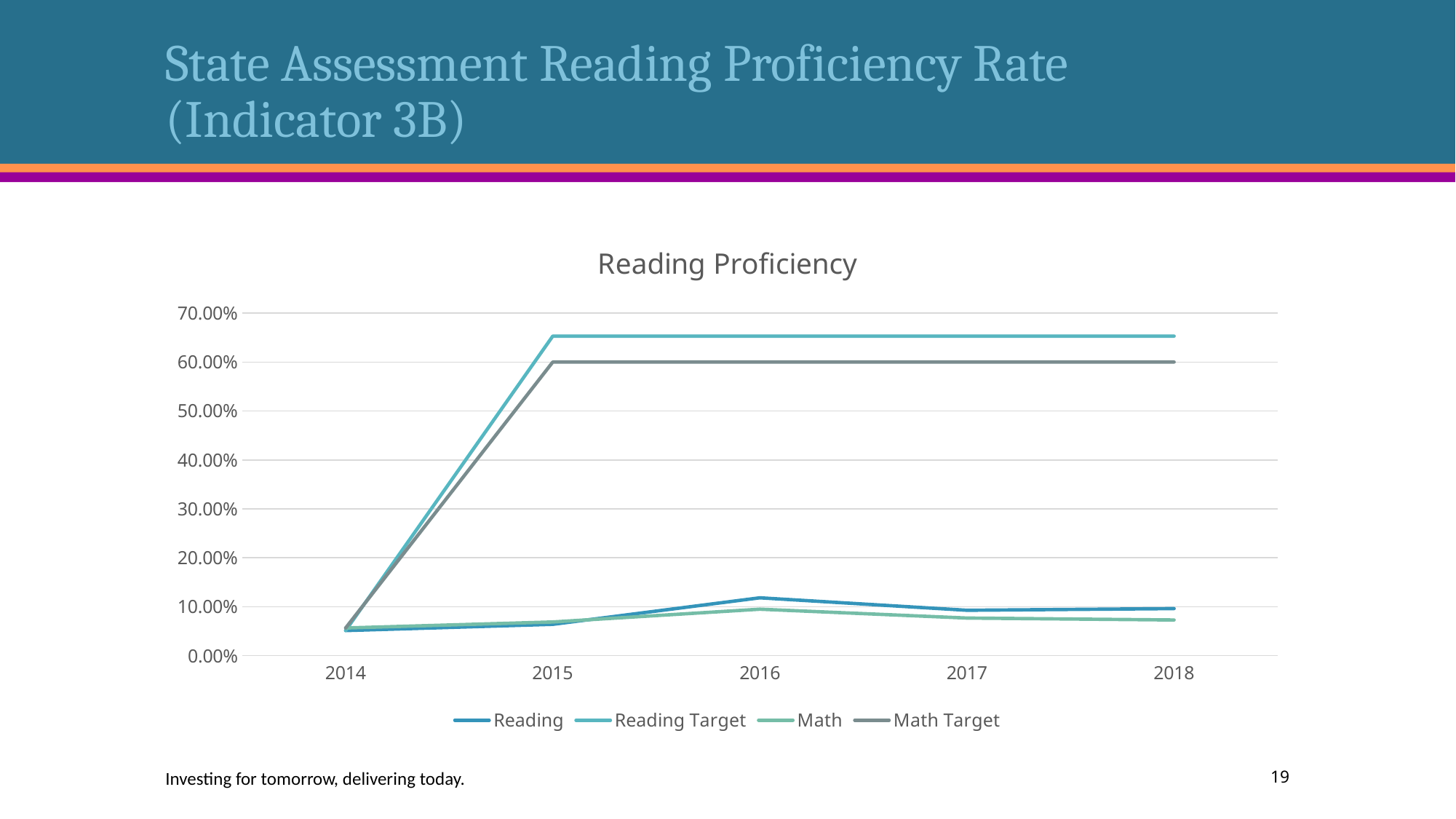
Which is larger in 2016, Reading or Math? Reading What is the value of Math Target in 2017? 60.00% Is the value for Reading in 2016 greater or less than 10.00%? greater Is the value for Math in 2018 greater or less than 10.00%? less Which series has the highest value in 2018? Reading Target Which series has the lowest value in 2018? Math Does the Reading Target series rise or fall from 2014 to 2015? rise What kind of chart is shown on the slide? line chart Is the value for Reading Target in 2016 greater or less than 60.00%? greater How many series does the legend list? 4 How many years are shown on the x axis? 5 What is the title of the chart? Reading Proficiency